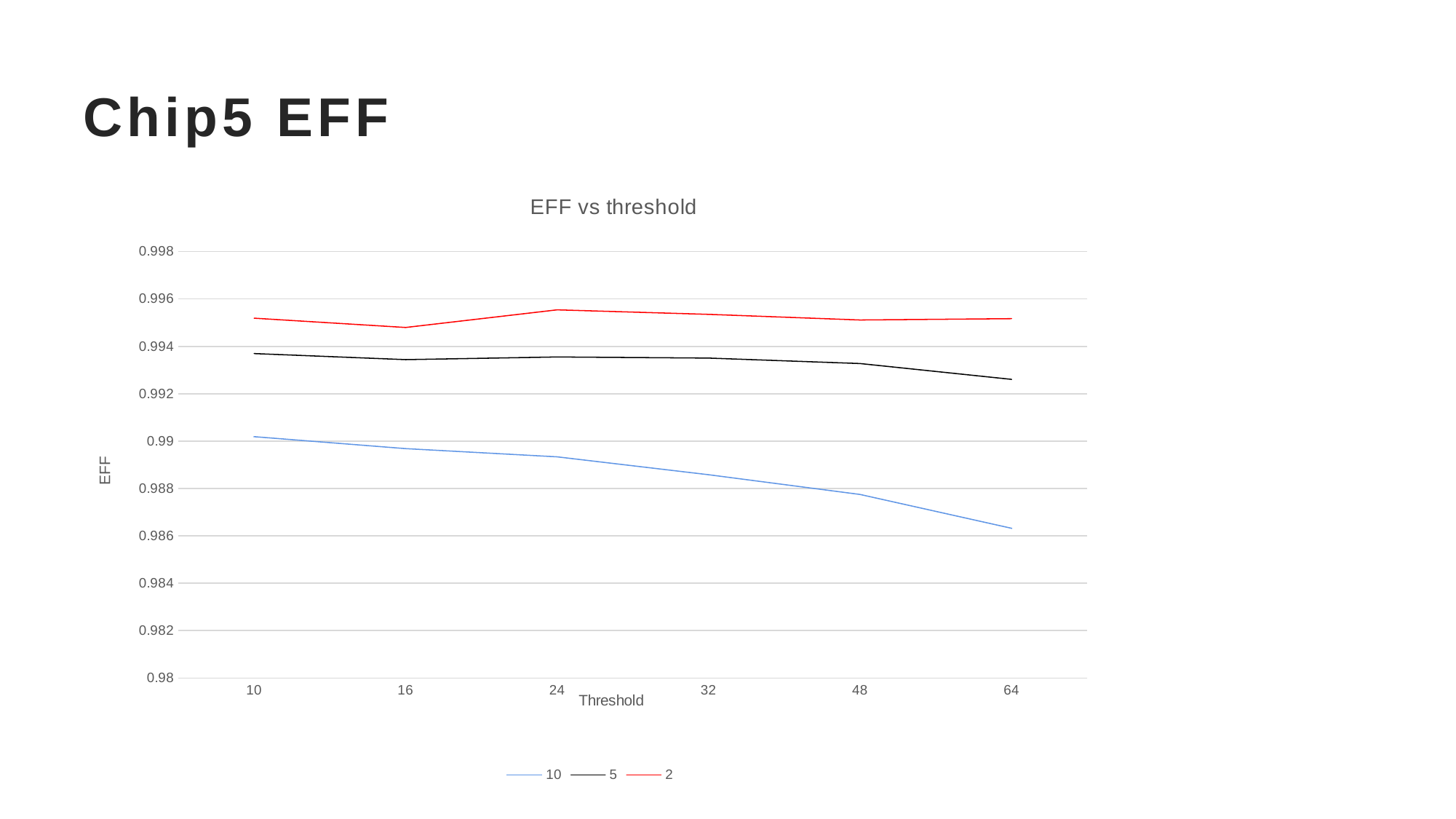
Does the value of series 10 rise or fall as the threshold increases from 10 to 64? fall How many series does the legend list? 3 Is the value for series 10 at threshold 64 greater or less than 0.988? less Is the value for series 2 at threshold 24 greater or less than 0.994? greater How many threshold values are plotted along the x axis? 6 At threshold 10, which series has the higher value, series 2 or series 10? 2 Which series has the lowest values across all thresholds? 10 Is the value for series 5 at threshold 64 greater or less than 0.992? greater Which series has the highest values across all thresholds? 2 What is the title of the chart? EFF vs threshold What kind of chart is shown on the slide? line chart At which threshold does series 10 reach its lowest value? 64